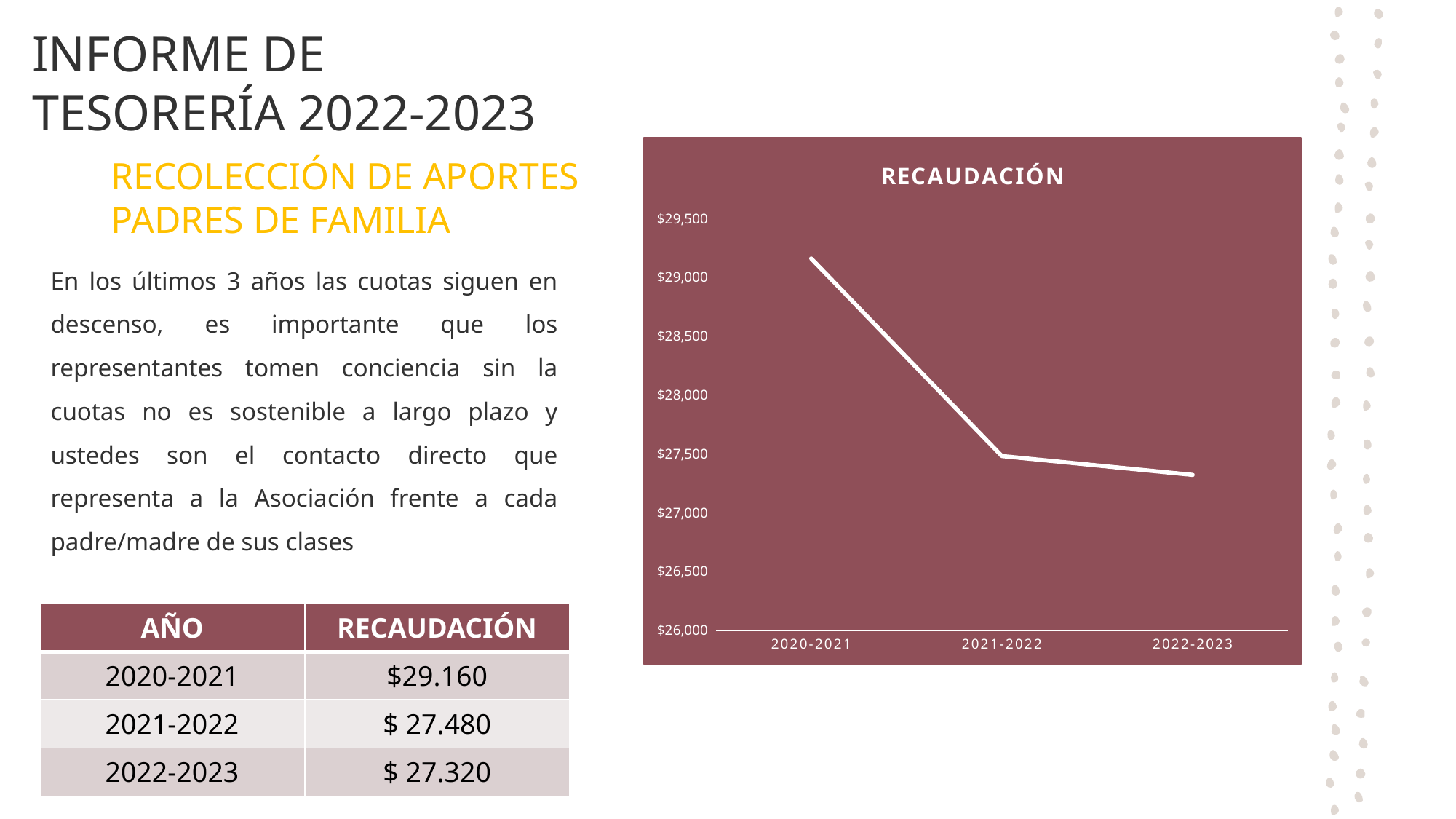
Which period has the lowest recaudación on the chart? 2022-2023 Is the value for 2021-2022 greater or less than $27,000? greater What colour is the line plotted on the chart? white According to the slide, what is the recaudación for 2020-2021? $29.160 How many data points are plotted on the chart? 3 Do the values on the chart rise or fall from 2020-2021 to 2022-2023? fall What kind of chart is shown on the slide? line chart Which is larger, the value for 2021-2022 or the value for 2022-2023? 2021-2022 Is the value for 2020-2021 greater or less than $29,000? greater Which period has the highest recaudación on the chart? 2020-2021 Is the value for 2022-2023 greater or less than $27,500? less What is the title of the chart? RECAUDACIÓN